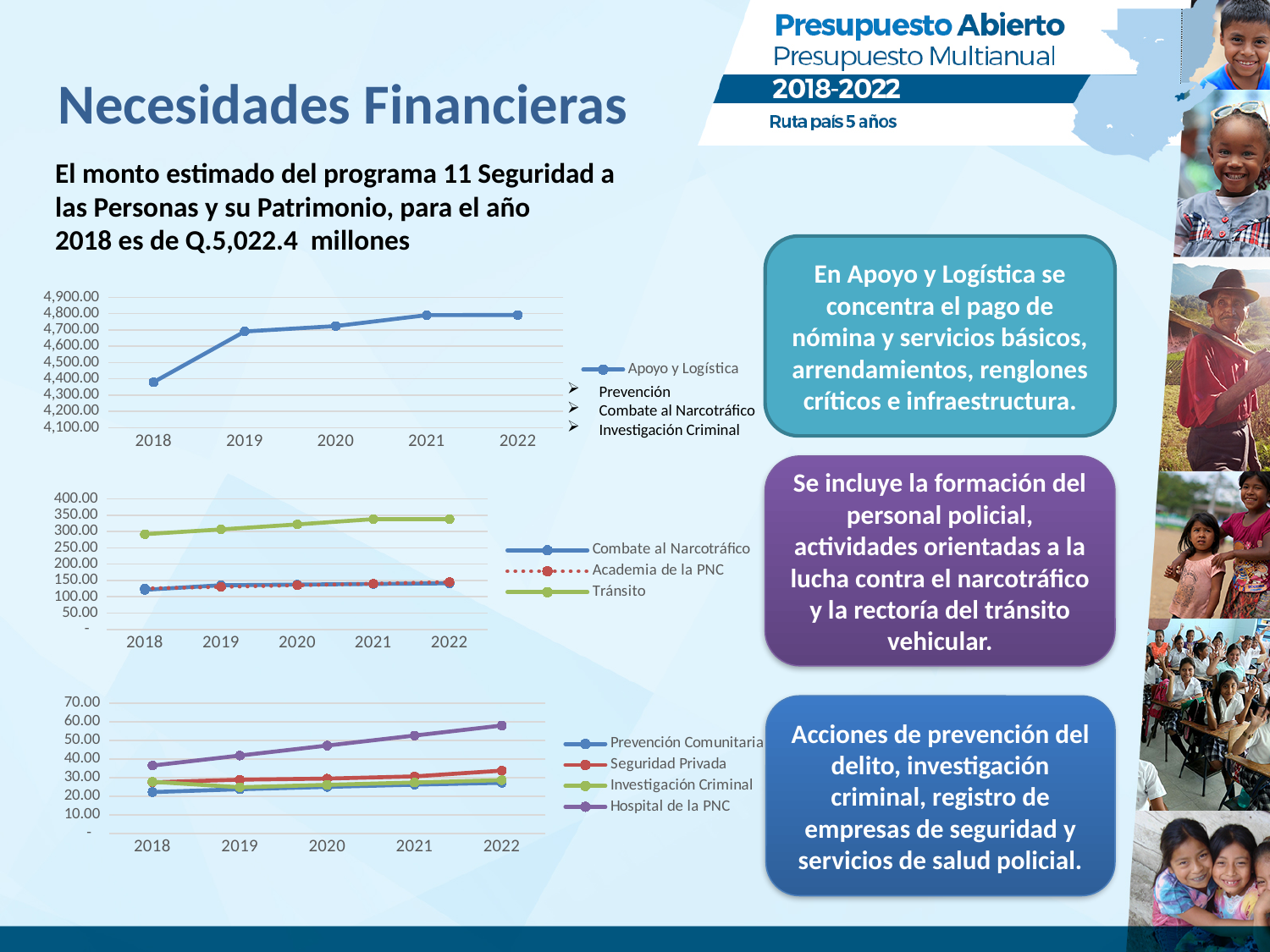
In the bottom chart, which is larger in 2018: Hospital de la PNC or Prevención Comunitaria? Hospital de la PNC In the top chart, is the value for Apoyo y Logística in 2021 greater or less than 4,700.00? greater How many series does the legend of the bottom chart list? 4 In the middle chart, which series has the highest values across all years? Tránsito In the top chart, how many years are plotted along the x axis? 5 What kind of chart is the top chart on the slide? line chart In the bottom chart, which series has the highest value in 2022? Hospital de la PNC In the bottom chart, is the value for Hospital de la PNC in 2022 greater or less than 50.00? greater In the top chart, does the Apoyo y Logística line rise or fall from 2018 to 2022? rise How many series does the legend of the middle chart list? 3 In the middle chart, is the value for Tránsito in 2022 greater or less than 300.00? greater